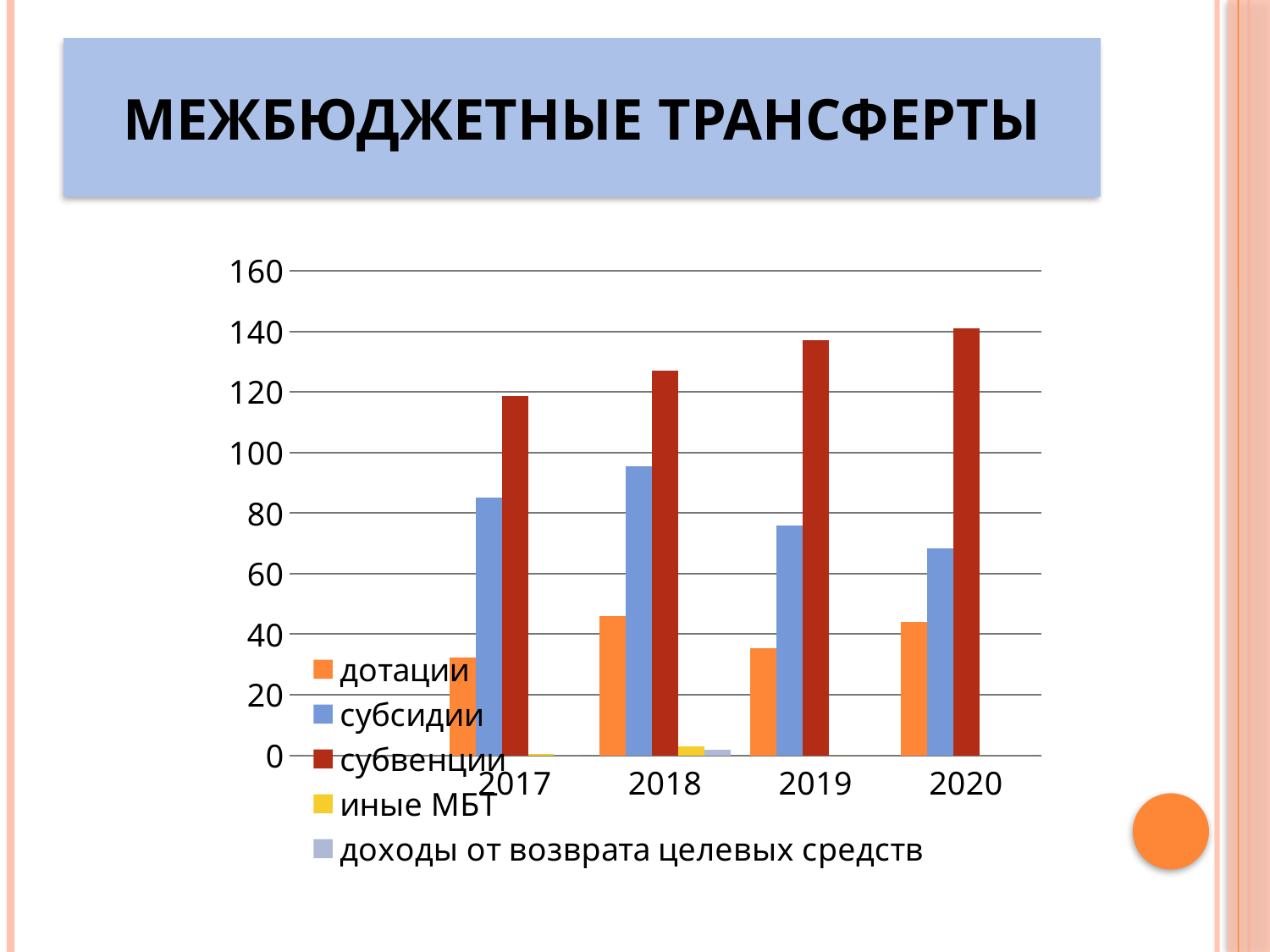
What kind of chart is shown on the slide? bar chart In which year is the value for субвенции the highest? 2020 Is the value for субсидии in 2020 greater or less than 80? less In which year is the value for субсидии the highest? 2018 Which is larger: субсидии in 2018 or субсидии in 2019? субсидии in 2018 Is the value for субвенции in 2017 greater or less than 100? greater Do the values for субвенции rise or fall from 2017 to 2020? rise How many years are shown on the x axis? 4 In which year is the value for субвенции the lowest? 2017 What is the title of the slide? МЕЖБЮДЖЕТНЫЕ ТРАНСФЕРТЫ Is the value for дотации in 2018 greater or less than 40? greater How many series does the legend list? 5